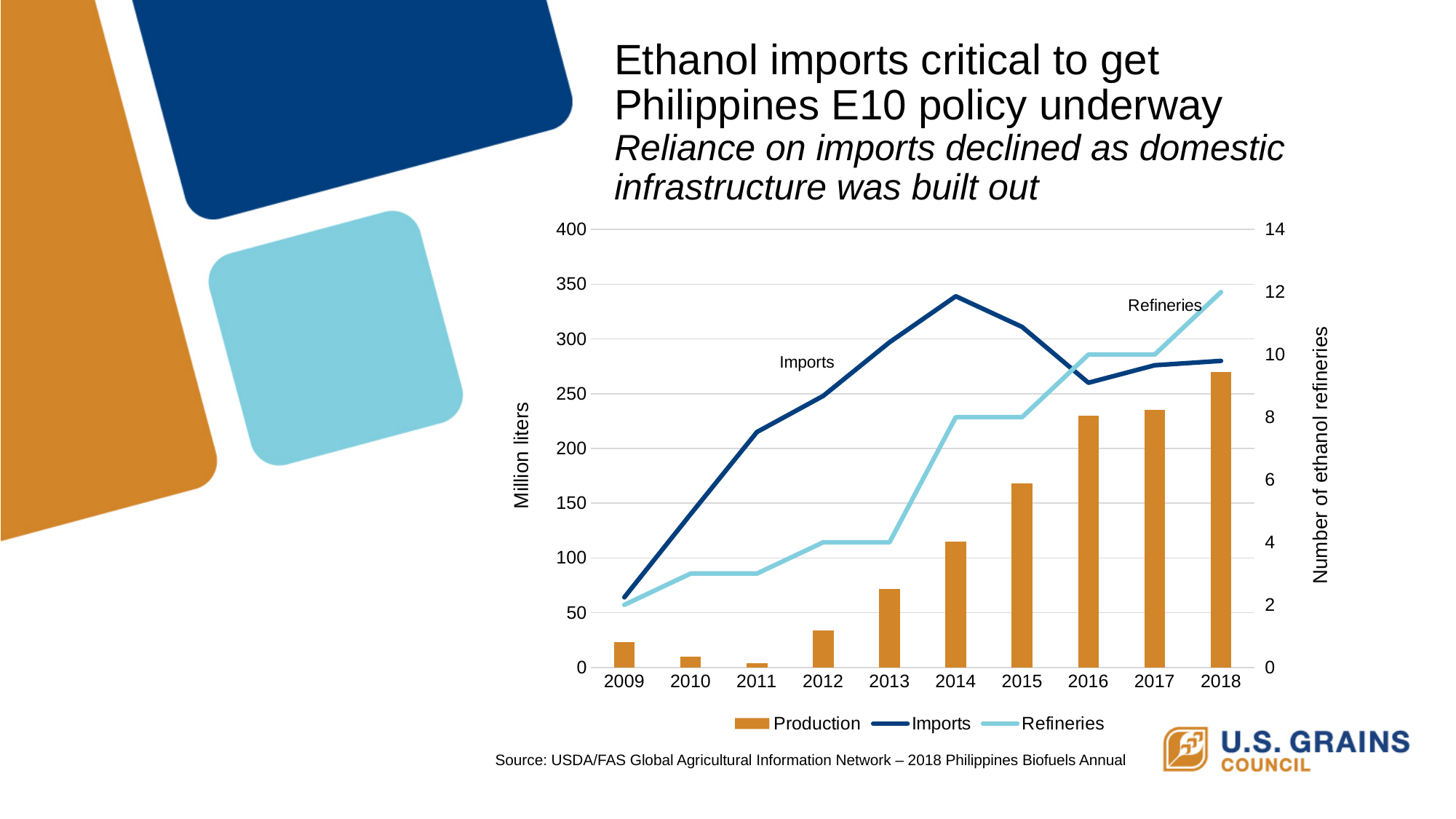
In which year do Imports reach their peak? 2014 In which year is Production lowest? 2011 How many series does the legend list? 3 In which year is Production highest? 2018 How many ethanol refineries are shown for 2016? 10 Is the Production value for 2013 greater or less than 100 million liters? less Which is larger in 2018, Imports or Production? Imports Do the number of refineries generally rise or fall from 2009 to 2018? Rise How many years are shown on the x axis? 10 What kind of chart is shown on the slide? Combined bar and line chart Is the Imports value for 2014 greater or less than 300 million liters? greater How many ethanol refineries are shown for 2018? 12